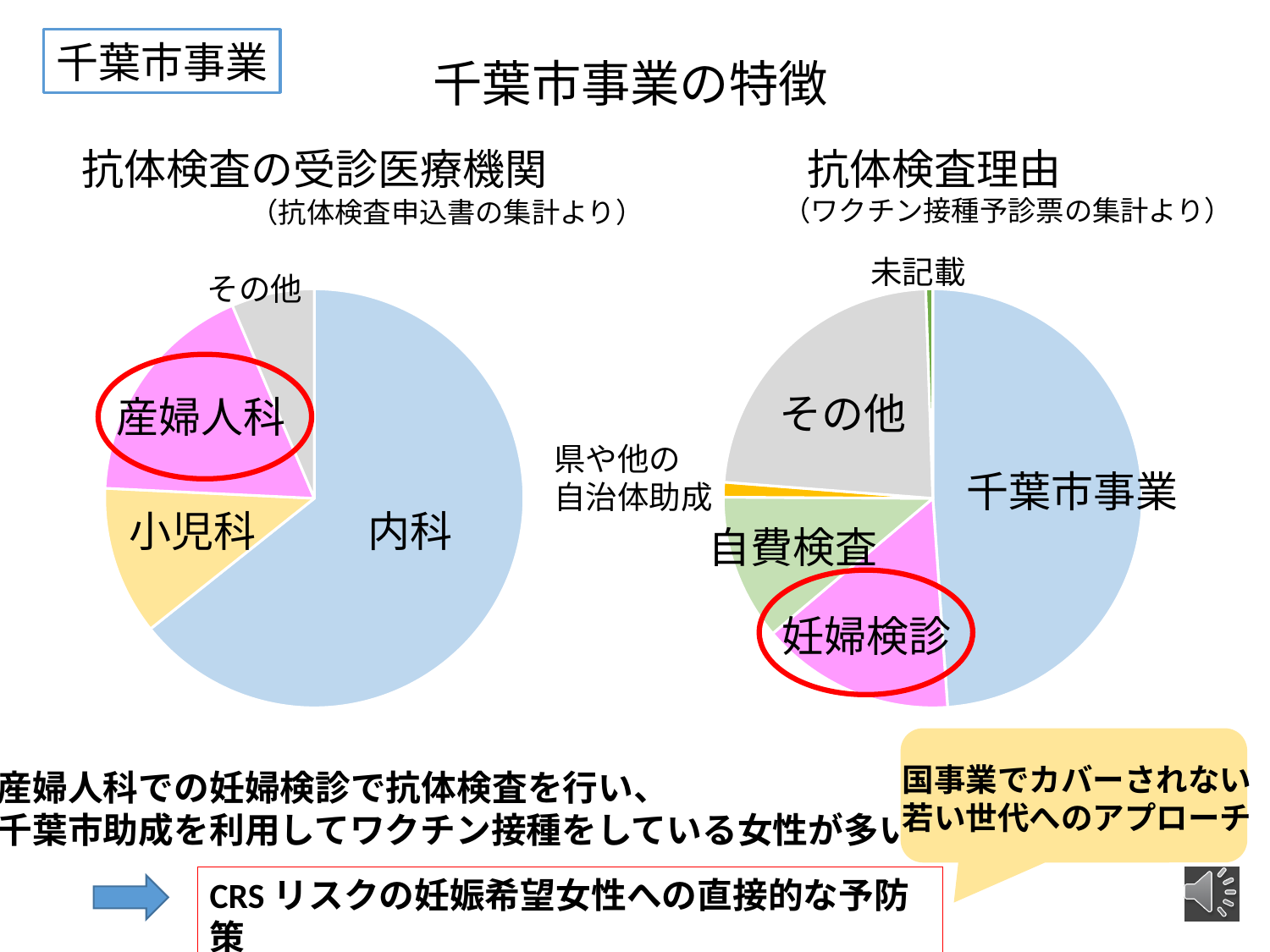
In the right chart (抗体検査理由), which category has the largest slice? 千葉市事業 In the right chart (抗体検査理由), which category is circled in red? 妊婦検診 In the right chart (抗体検査理由), which slice is larger, 自費検査 or 県や他の自治体助成? 自費検査 How many categories are shown in the left chart (抗体検査の受診医療機関)? 4 In the left chart (抗体検査の受診医療機関), which category has the largest slice? 内科 How many categories are shown in the right chart (抗体検査理由)? 6 In the right chart (抗体検査理由), which slice is larger, 千葉市事業 or その他? 千葉市事業 What kind of chart is the right chart titled 抗体検査理由? pie chart In the left chart (抗体検査の受診医療機関), which category has the smallest slice? その他 In the left chart (抗体検査の受診医療機関), which slice is larger, 内科 or 小児科? 内科 What kind of chart is the left chart titled 抗体検査の受診医療機関? pie chart In the left chart (抗体検査の受診医療機関), which category is circled in red? 産婦人科